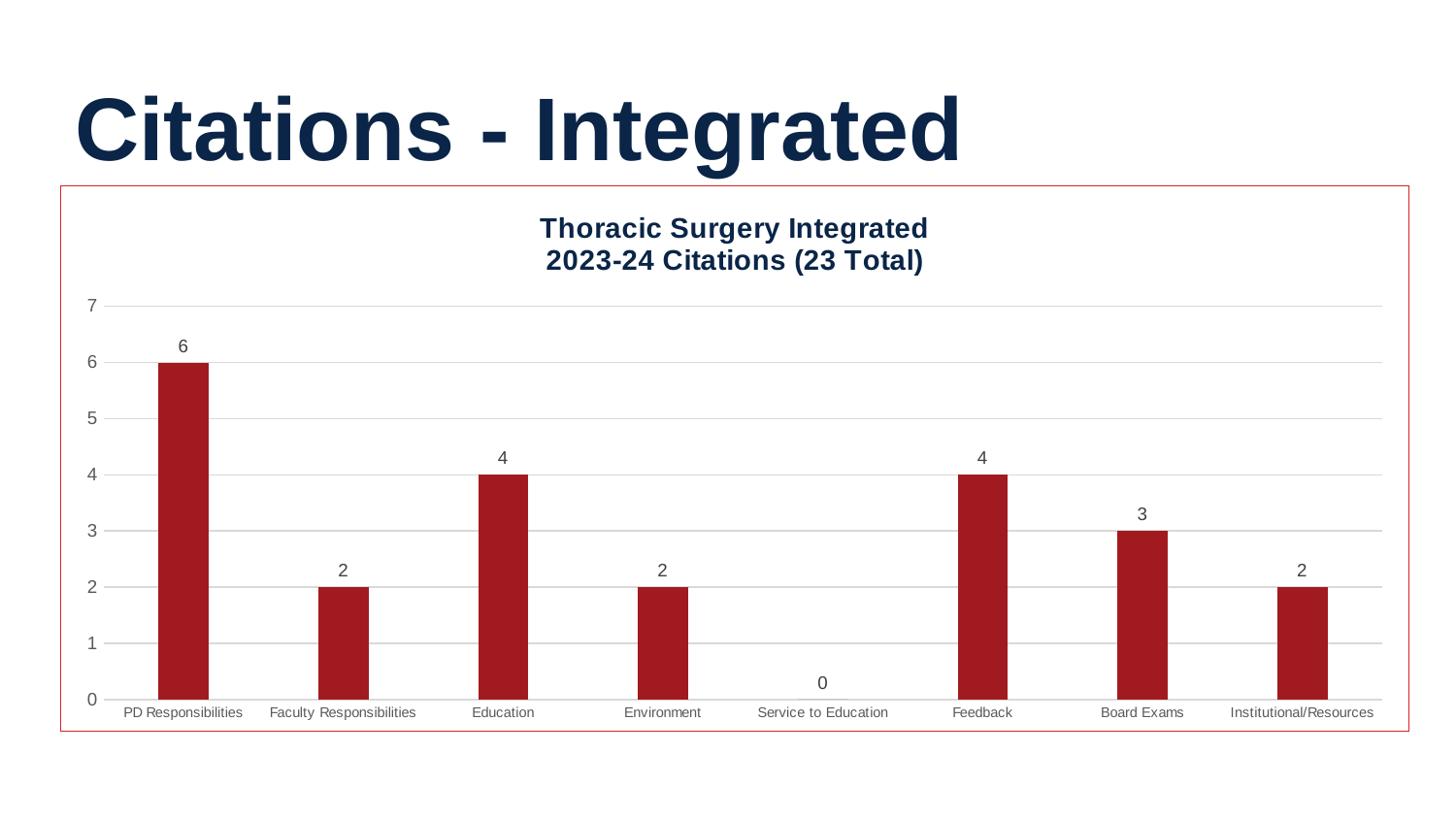
What is the highest value shown on the y axis? 7 How many categories are shown on the x axis? 8 What is the value for Board Exams? 3 What is the title of the chart? Thoracic Surgery Integrated 2023-24 Citations (23 Total) What is the difference between the values for PD Responsibilities and Feedback? 2 Which category has the lowest value? Service to Education What is the value for Service to Education? 0 Which is larger, the value for Education or the value for Board Exams? Education Which category has the highest value? PD Responsibilities What is the value for PD Responsibilities? 6 What is the difference between the values for Feedback and Institutional/Resources? 2 What kind of chart is shown on the slide? Bar chart